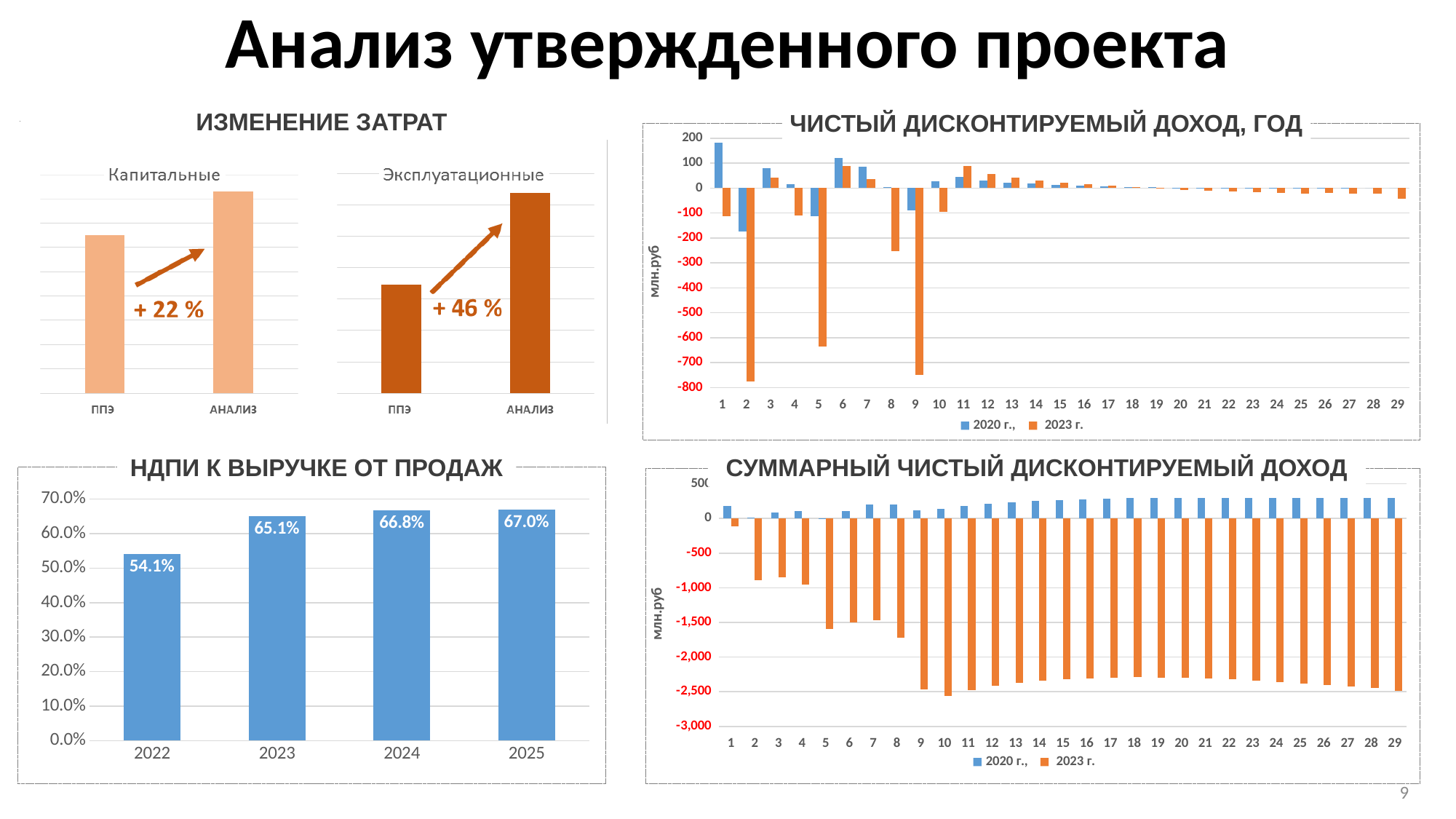
In the chart 'ЧИСТЫЙ ДИСКОНТИРУЕМЫЙ ДОХОД, ГОД', how many series does the legend list? 2 In the chart 'НДПИ К ВЫРУЧКЕ ОТ ПРОДАЖ', what is the value for 2022? 54.1% In the chart 'НДПИ К ВЫРУЧКЕ ОТ ПРОДАЖ', which year has the lowest value? 2022 In the chart 'НДПИ К ВЫРУЧКЕ ОТ ПРОДАЖ', what is the difference between the 2023 and 2022 values? 11.0% In the chart 'ЧИСТЫЙ ДИСКОНТИРУЕМЫЙ ДОХОД, ГОД', how many years are shown on the x axis? 29 In the chart 'НДПИ К ВЫРУЧКЕ ОТ ПРОДАЖ', do the values rise or fall from 2022 to 2025? rise In the 'ИЗМЕНЕНИЕ ЗАТРАТ' section, what percentage change is shown for Эксплуатационные costs? + 46 % What kind of chart is 'НДПИ К ВЫРУЧКЕ ОТ ПРОДАЖ'? bar chart In the chart 'ЧИСТЫЙ ДИСКОНТИРУЕМЫЙ ДОХОД, ГОД', is the 2023 г. value for year 2 greater or less than -700? less In the chart 'НДПИ К ВЫРУЧКЕ ОТ ПРОДАЖ', what is the value for 2025? 67.0% In the chart 'ЧИСТЫЙ ДИСКОНТИРУЕМЫЙ ДОХОД, ГОД', for year 1, which series has the larger value: 2020 г. or 2023 г.? 2020 г. In the chart 'НДПИ К ВЫРУЧКЕ ОТ ПРОДАЖ', how many years are shown? 4